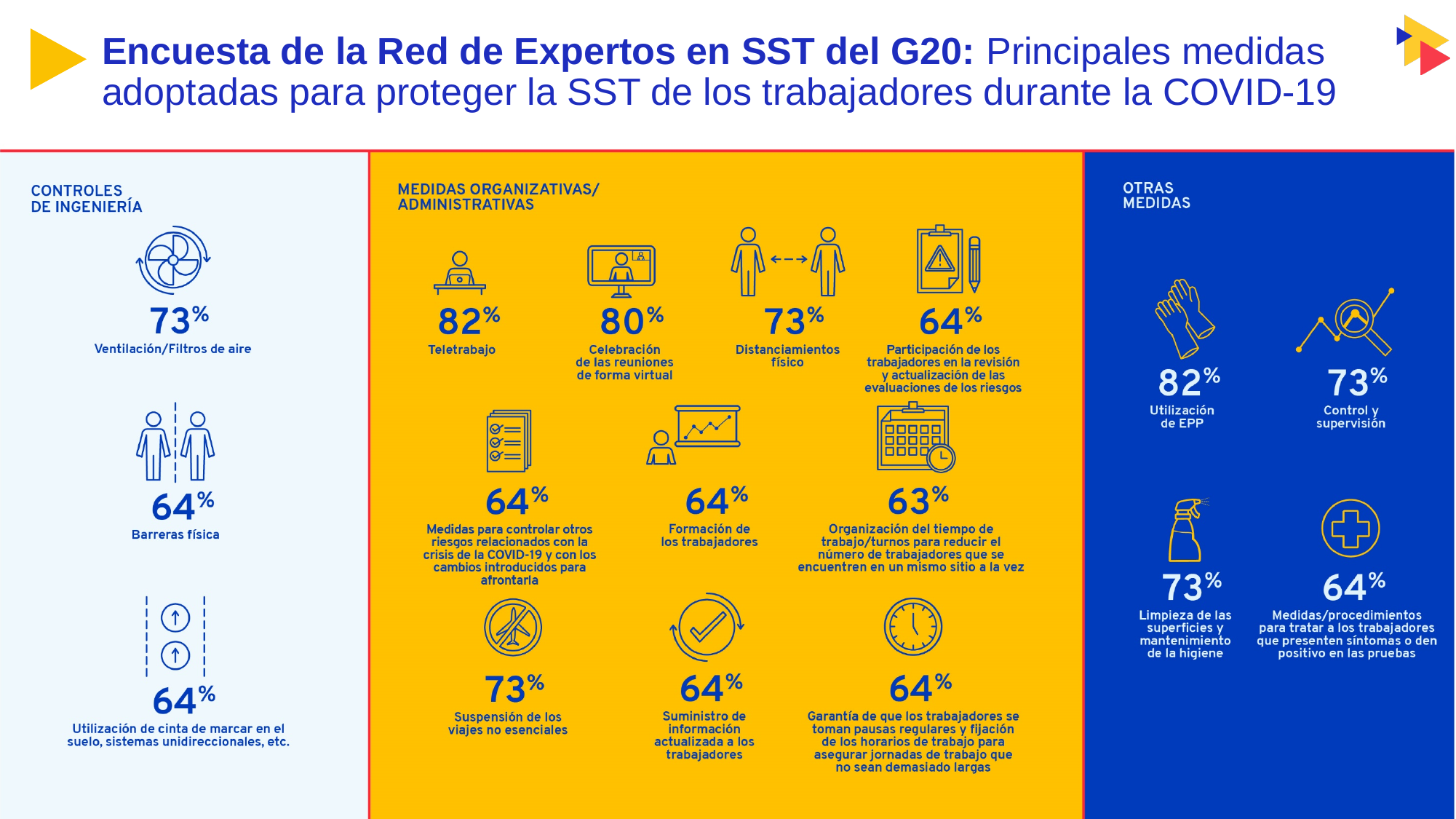
Which measure in the Medidas organizativas/administrativas section has the highest percentage? Teletrabajo Which measure in the Medidas organizativas/administrativas section has the lowest percentage? Organización del tiempo de trabajo/turnos para reducir el número de trabajadores que se encuentren en un mismo sitio a la vez How many sections (categories of measures) does the infographic divide the measures into? 3 How many measures are listed in the Medidas organizativas/administrativas section? 10 Which has a higher percentage: Limpieza de las superficies y mantenimiento de la higiene or Medidas/procedimientos para tratar a los trabajadores que presenten síntomas? Limpieza de las superficies y mantenimiento de la higiene What percentage is shown for Organización del tiempo de trabajo/turnos in the Medidas organizativas/administrativas section? 63% What percentage is shown for Celebración de las reuniones de forma virtual? 80% What percentage is shown for Ventilación/Filtros de aire in the Controles de ingeniería section? 73% What is the difference between the percentage for Teletrabajo and the percentage for Distanciamientos físico? 9% Which measure in the Controles de ingeniería section has the highest percentage? Ventilación/Filtros de aire What percentage is shown for Utilización de EPP in the Otras medidas section? 82% What percentage is shown for Teletrabajo in the Medidas organizativas/administrativas section? 82%